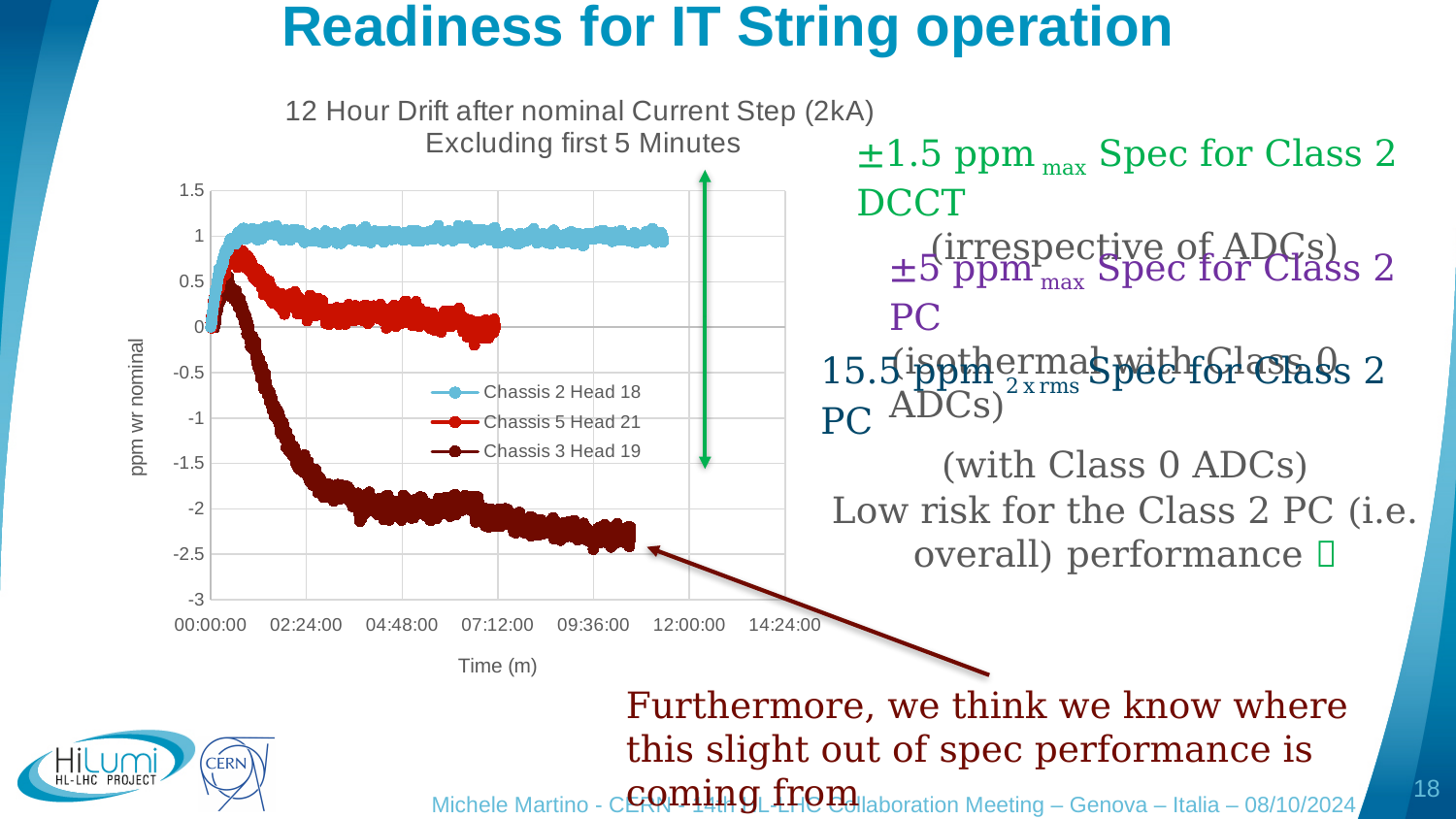
How many series does the chart legend list? 3 What is the label of the chart's y axis? ppm wr nominal What is the lowest tick value shown on the y axis? -3 What is the title of the chart? 12 Hour Drift after nominal Current Step (2kA) Excluding first 5 Minutes Is the final value for Chassis 5 Head 21 greater or less than -0.5? greater Which series has the lowest values at the end of its trace? Chassis 3 Head 19 Which series has larger values at the end, Chassis 5 Head 21 or Chassis 3 Head 19? Chassis 5 Head 21 Which series has the highest values at the end of its trace? Chassis 2 Head 18 Is the final value for Chassis 3 Head 19 greater or less than -2? less What kind of chart is shown on the slide? Scatter (line) chart Does the Chassis 3 Head 19 series rise or fall over time after its initial peak? fall Is the settled value for Chassis 2 Head 18 greater or less than 0.5? greater